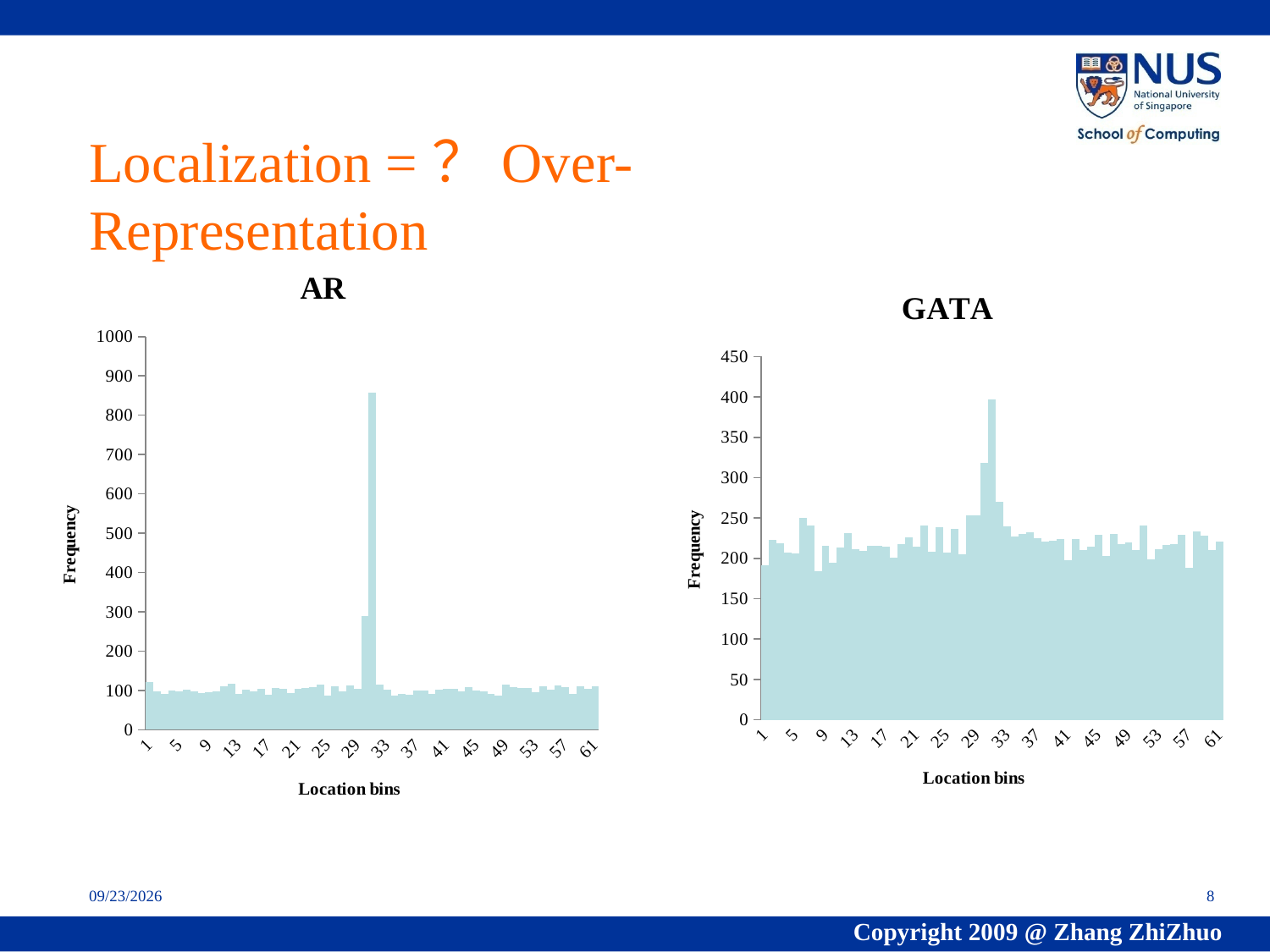
Which chart has the higher peak frequency, AR or GATA? AR What kind of chart is the AR chart? bar chart What kind of chart is the GATA chart? bar chart In the GATA chart, is the value for location bin 1 greater or less than 300? less What is the x-axis title of the GATA chart? Location bins In the AR chart, is the value for location bin 1 greater or less than 200? less In the GATA chart, is the value for location bin 61 greater or less than 300? less What is the highest value shown on the y-axis of the AR chart? 1000 What is the title of the chart on the left? AR